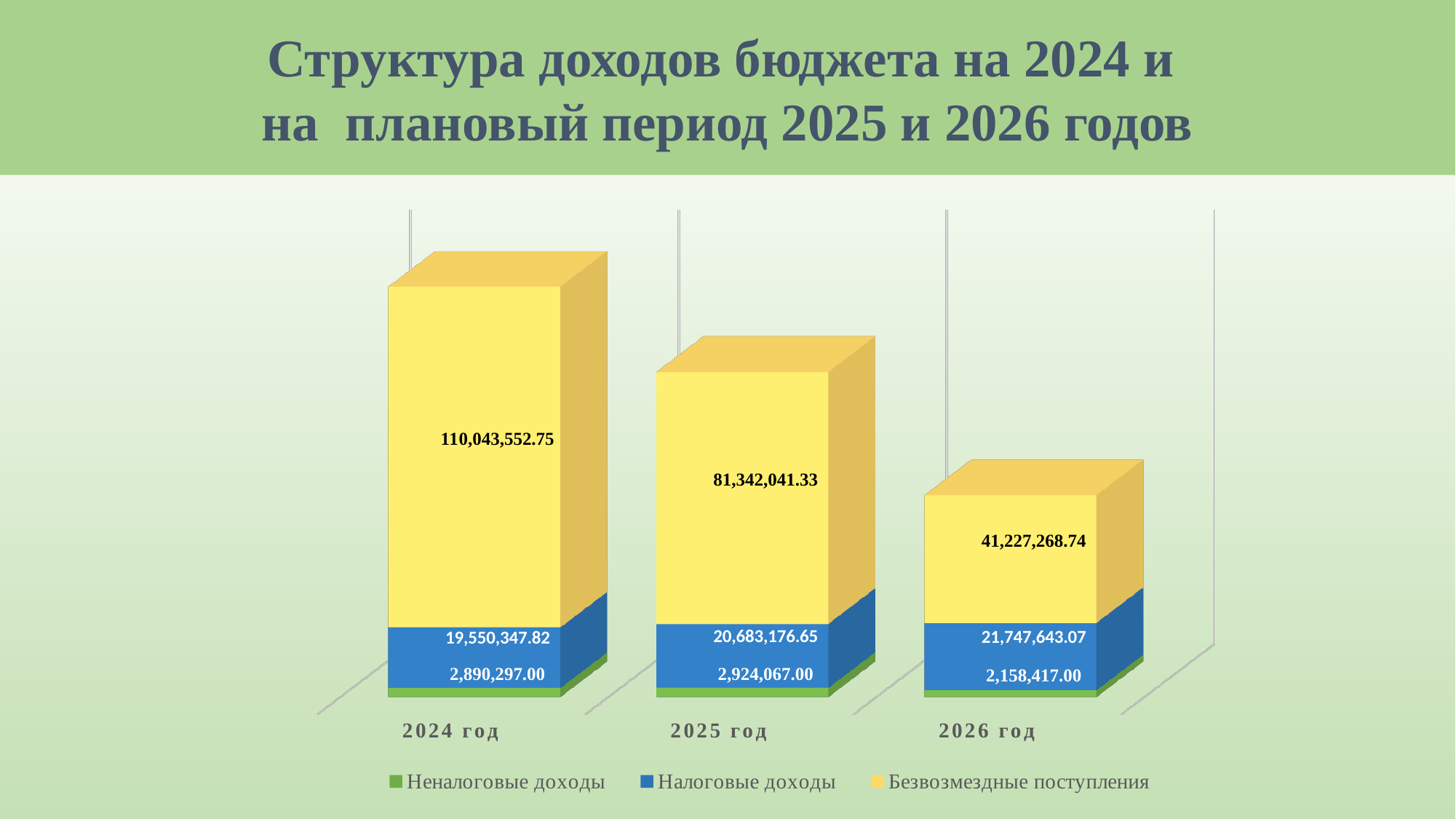
In which year is Безвозмездные поступления the lowest? 2026 год What is the value of Неналоговые доходы for 2026 год? 2,158,417.00 How many series does the legend list? 3 What is the value of Налоговые доходы for 2025 год? 20,683,176.65 What is the total of the stacked bar for 2026 год? 65,133,328.81 What is the difference between Безвозмездные поступления in 2024 год and 2025 год? 28,701,511.42 In which year is Налоговые доходы the highest? 2026 год Which is larger: Неналоговые доходы in 2024 год or in 2025 год? 2025 год How many categories (years) are shown on the x axis? 3 What type of chart is shown on the slide? Stacked bar chart What is the value of Безвозмездные поступления for 2024 год? 110,043,552.75 Do the values of Безвозмездные поступления rise or fall from 2024 to 2026? Fall